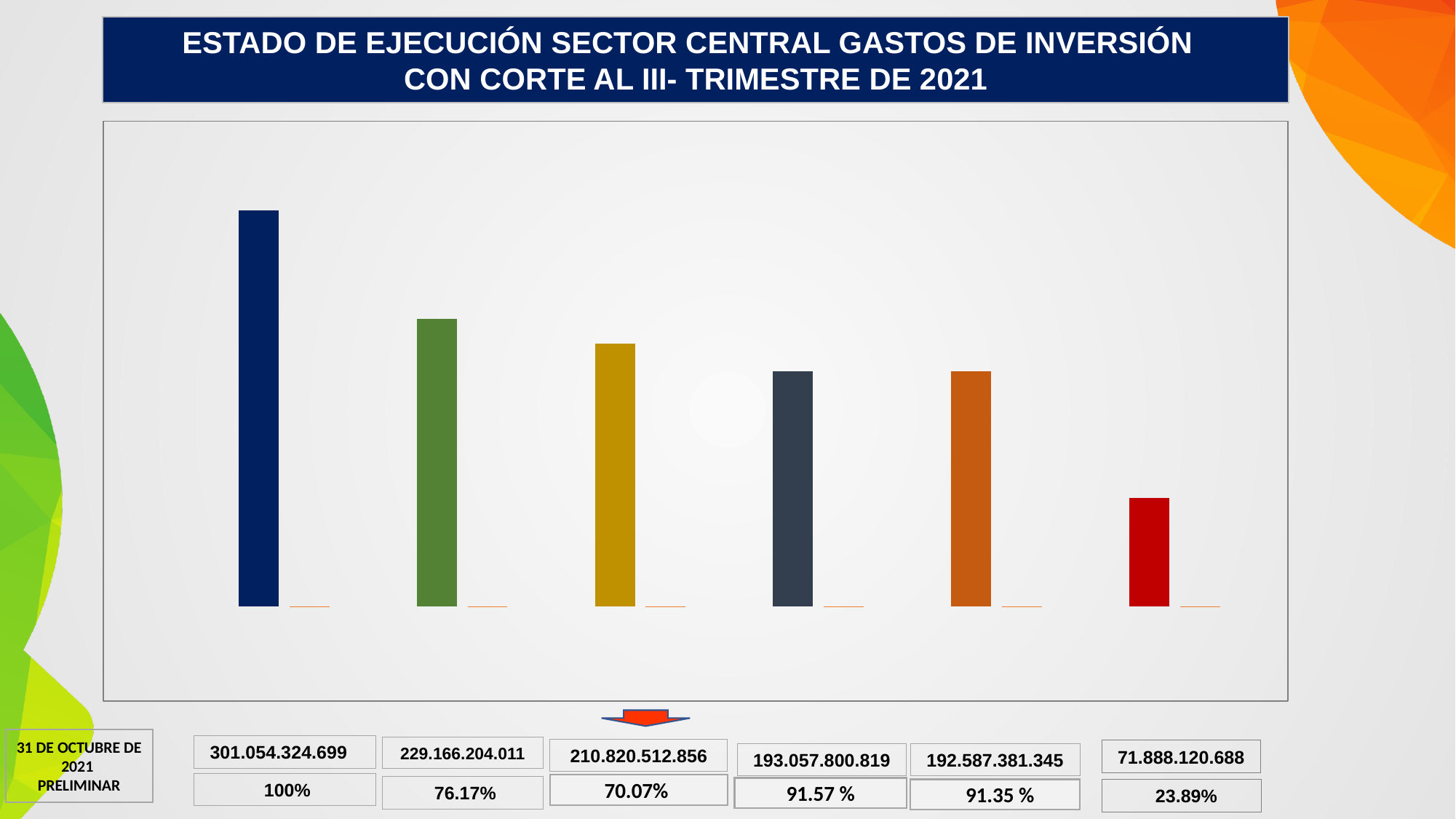
How many bars are plotted in the chart? 6 What percentage is printed below the second (green) bar? 76.17% What is the difference between the value printed below the first (dark blue) bar and the value printed below the last (red) bar? 229.166.204.011 What kind of chart is shown on the slide? bar chart Do the bar heights rise or fall from left to right across the chart? fall What percentage is printed below the last (red) bar? 23.89% Which bar is the shortest in the chart? the last (red) bar What is the title of the chart on the slide? ESTADO DE EJECUCIÓN SECTOR CENTRAL GASTOS DE INVERSIÓN CON CORTE AL III- TRIMESTRE DE 2021 Which bar is the tallest in the chart? the first (dark blue) bar Is the second (green) bar taller or shorter than the third (yellow) bar? taller What value is printed below the first (dark blue) bar? 301.054.324.699 What value is printed below the third (yellow) bar? 210.820.512.856